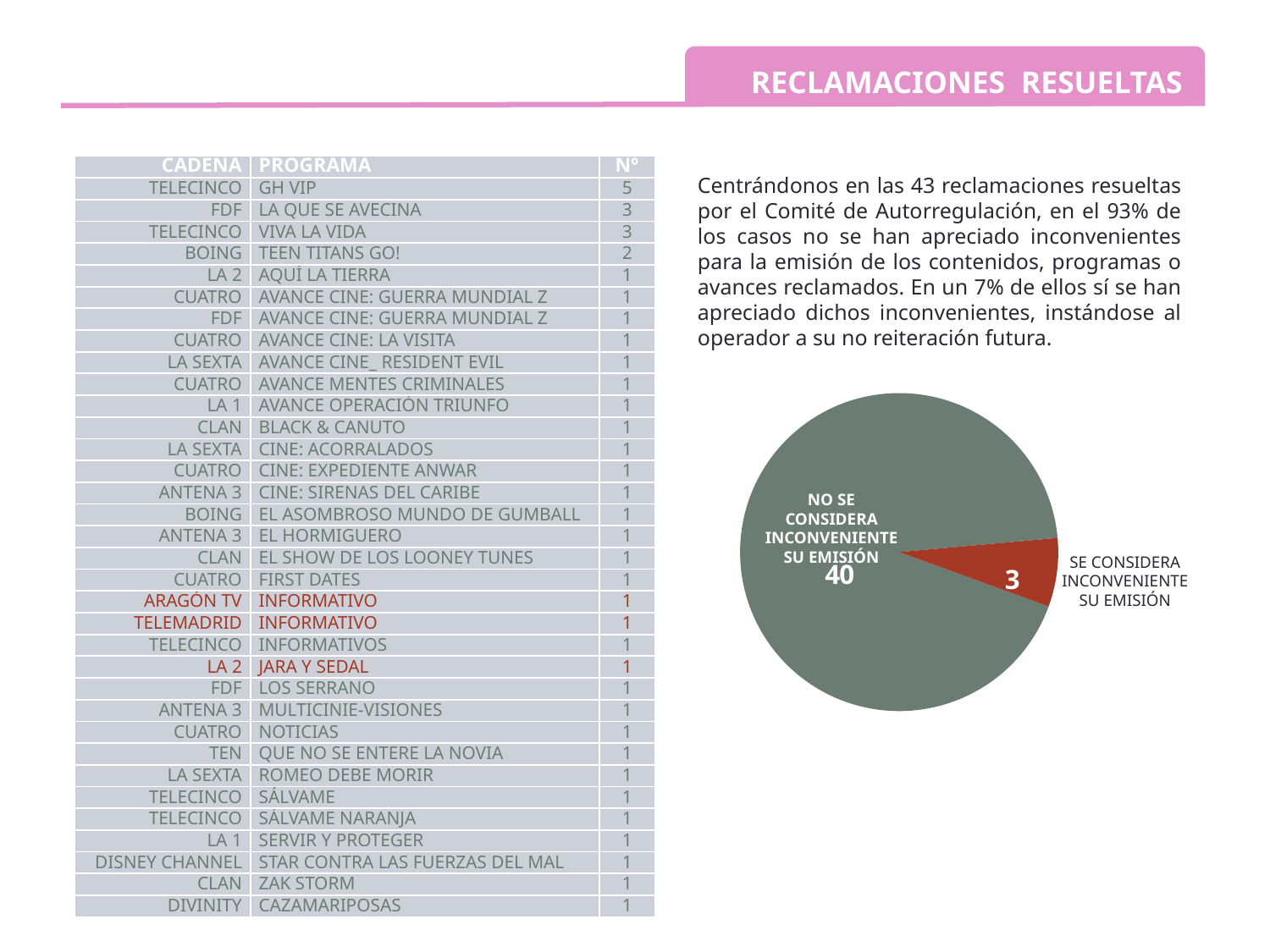
How many slices does the pie chart have? 2 What share of the pie does the slice "NO SE CONSIDERA INCONVENIENTE SU EMISIÓN" represent? 93% Which is larger: the slice "SE CONSIDERA INCONVENIENTE SU EMISIÓN" or the slice "NO SE CONSIDERA INCONVENIENTE SU EMISIÓN"? NO SE CONSIDERA INCONVENIENTE SU EMISIÓN What colour is the slice labelled "SE CONSIDERA INCONVENIENTE SU EMISIÓN"? red What is the value of the slice labelled "NO SE CONSIDERA INCONVENIENTE SU EMISIÓN"? 40 What is the total of the two slices in the pie chart? 43 What is the value of the slice labelled "SE CONSIDERA INCONVENIENTE SU EMISIÓN"? 3 What is the difference between the two slice values in the pie chart? 37 What kind of chart is shown on the slide? pie chart Which slice of the pie chart is the largest? NO SE CONSIDERA INCONVENIENTE SU EMISIÓN Which slice of the pie chart is the smallest? SE CONSIDERA INCONVENIENTE SU EMISIÓN What share of the pie does the slice "SE CONSIDERA INCONVENIENTE SU EMISIÓN" represent? 7%